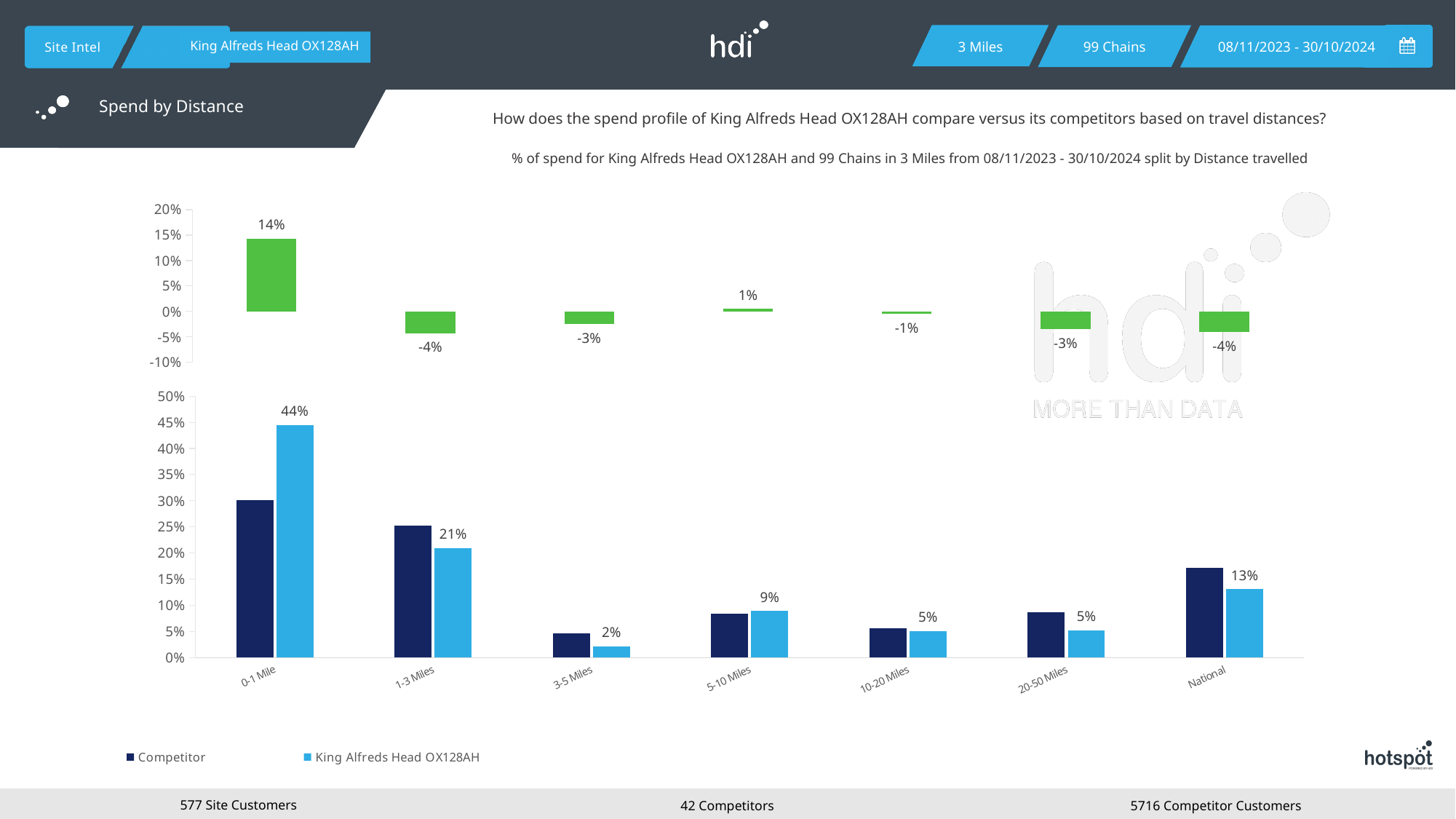
What type of chart is the bottom chart? Bar chart In the bottom chart, which distance category has the lowest value for King Alfreds Head OX128AH? 3-5 Miles How many distance categories are shown on the x axis of the bottom chart? 7 In the top chart, what is the value shown for the 0-1 Mile category? 14% In the bottom chart, which distance category has the highest value for King Alfreds Head OX128AH? 0-1 Mile In the bottom chart, what is the value for King Alfreds Head OX128AH in the 0-1 Mile category? 44% In the bottom chart, what is the difference between the King Alfreds Head OX128AH values for 0-1 Mile and 1-3 Miles? 23% In the bottom chart, what is the value for King Alfreds Head OX128AH for National? 13% In the top chart, what is the value shown for the 1-3 Miles category? -4% In the bottom chart, for the National category, which series has the larger value, Competitor or King Alfreds Head OX128AH? Competitor In the bottom chart, is the Competitor value for 0-1 Mile greater or less than 25%? greater How many series does the legend of the bottom chart list? 2